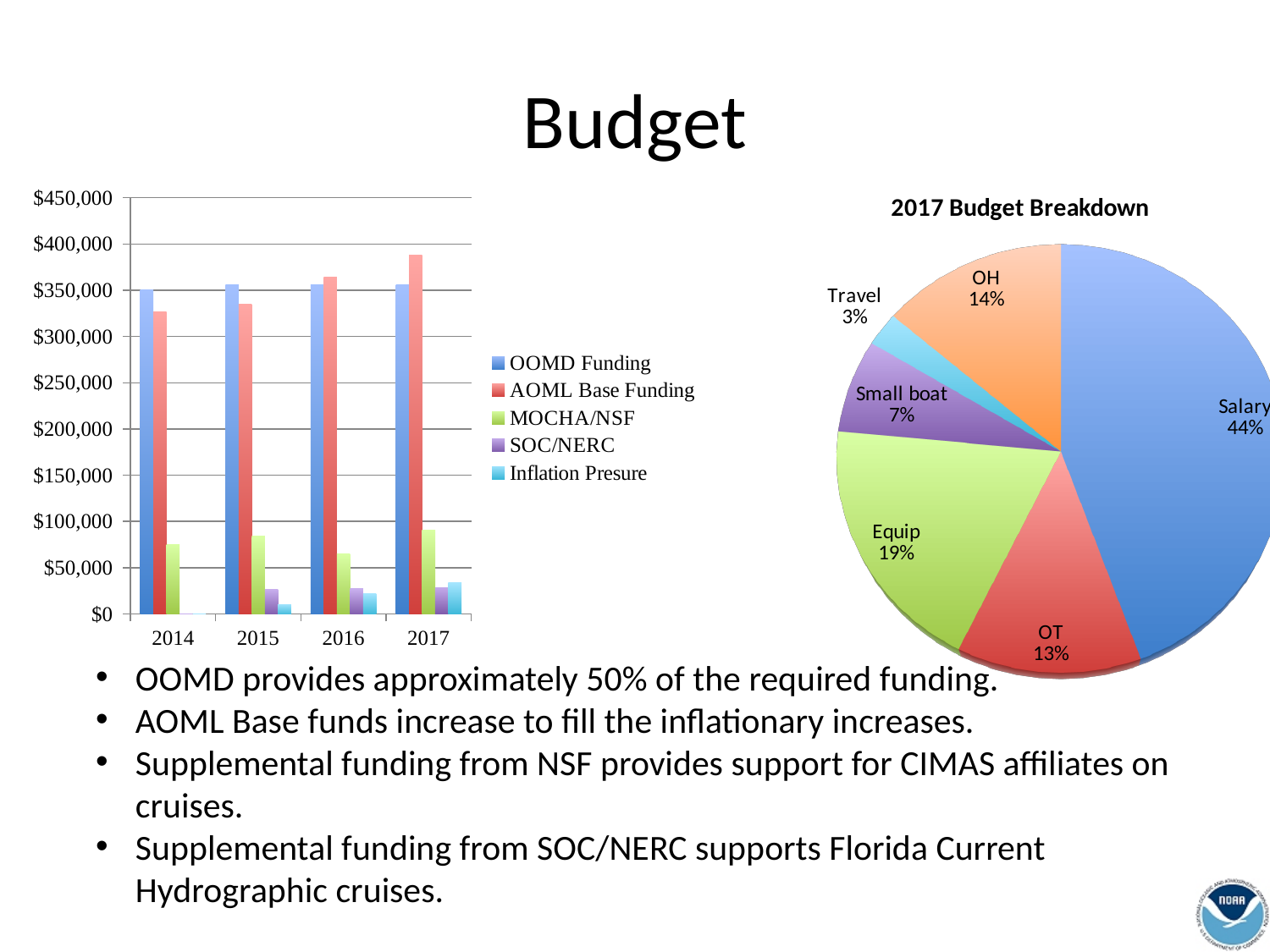
In the 2017 Budget Breakdown pie chart, what is the difference in percentage points between OH and OT? 1% In the 2017 Budget Breakdown pie chart, which category has the largest share? Salary In the bar chart on the left, how many years are shown on the x axis? 4 In the 2017 Budget Breakdown pie chart, what percentage is shown for Equip? 19% In the 2017 Budget Breakdown pie chart, which is larger, Small boat or Travel? Small boat In the bar chart on the left, does AOML Base Funding rise or fall from 2014 to 2017? Rise In the 2017 Budget Breakdown pie chart, which category has the smallest share? Travel In the bar chart on the left, is the AOML Base Funding value for 2017 greater or less than $350,000? greater What kind of chart is the chart on the left side of the slide? Bar chart In the 2017 Budget Breakdown pie chart, how many slices are there? 6 In the 2017 Budget Breakdown pie chart, what share of the budget is Salary? 44% In the bar chart on the left, how many series does the legend list? 5